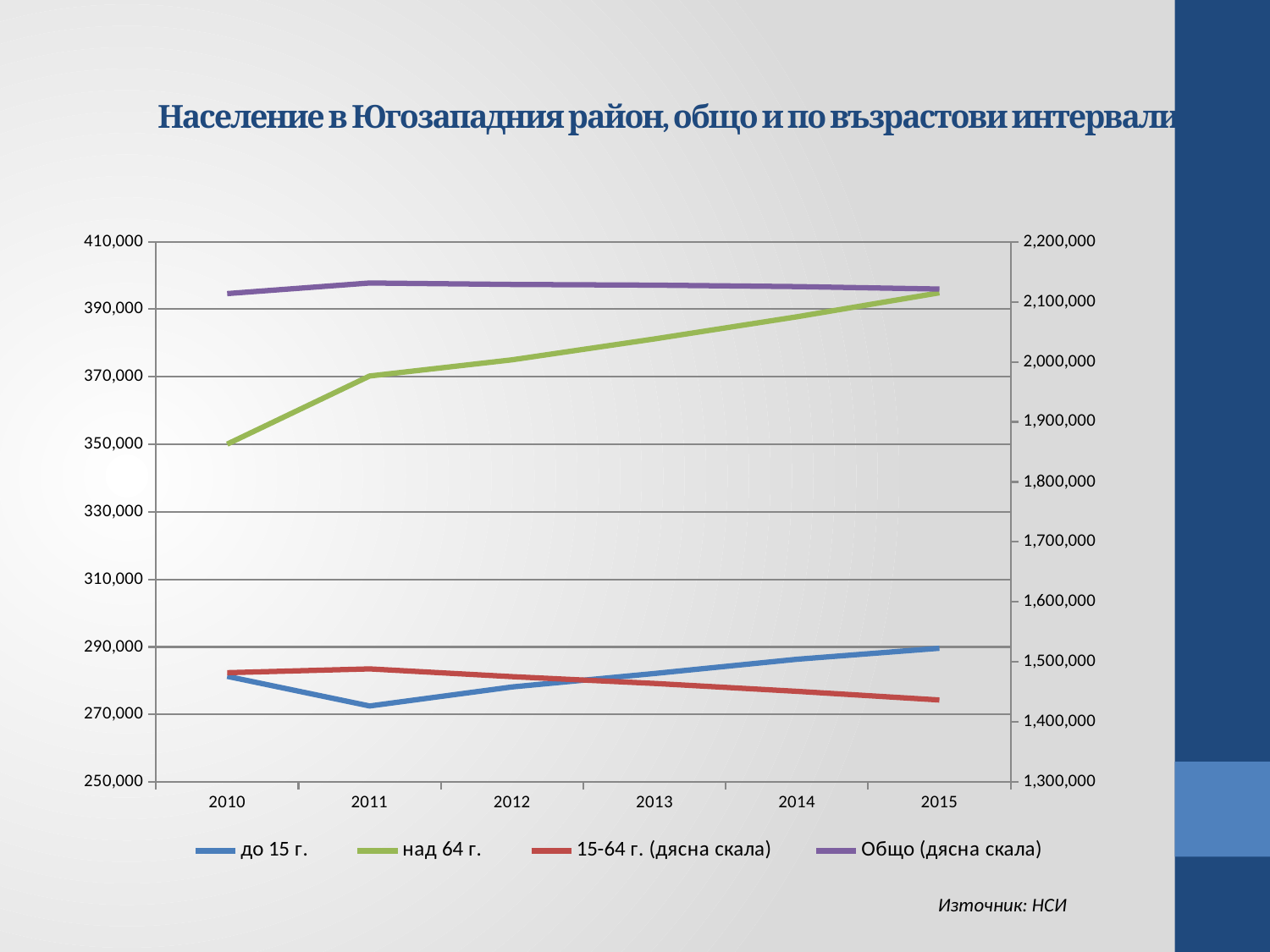
In 2010, which series has the higher value on the left axis: "над 64 г." or "до 15 г."? над 64 г. Is the value for "над 64 г." in 2015 greater or less than 370,000? greater What source is cited below the chart? НСИ Does the line for "над 64 г." rise or fall from 2010 to 2015? rise In which year is the value for "до 15 г." lowest? 2011 Does the line for "15-64 г. (дясна скала)" rise or fall from 2011 to 2015? fall In which year is the value for "над 64 г." highest? 2015 Is the value for "до 15 г." in 2011 greater or less than 290,000? less How many years are plotted along the x axis? 6 How many series does the legend list? 4 Is the value for "15-64 г. (дясна скала)" in 2015 greater or less than 1,500,000 on the right axis? less What kind of chart is shown on the slide? line chart